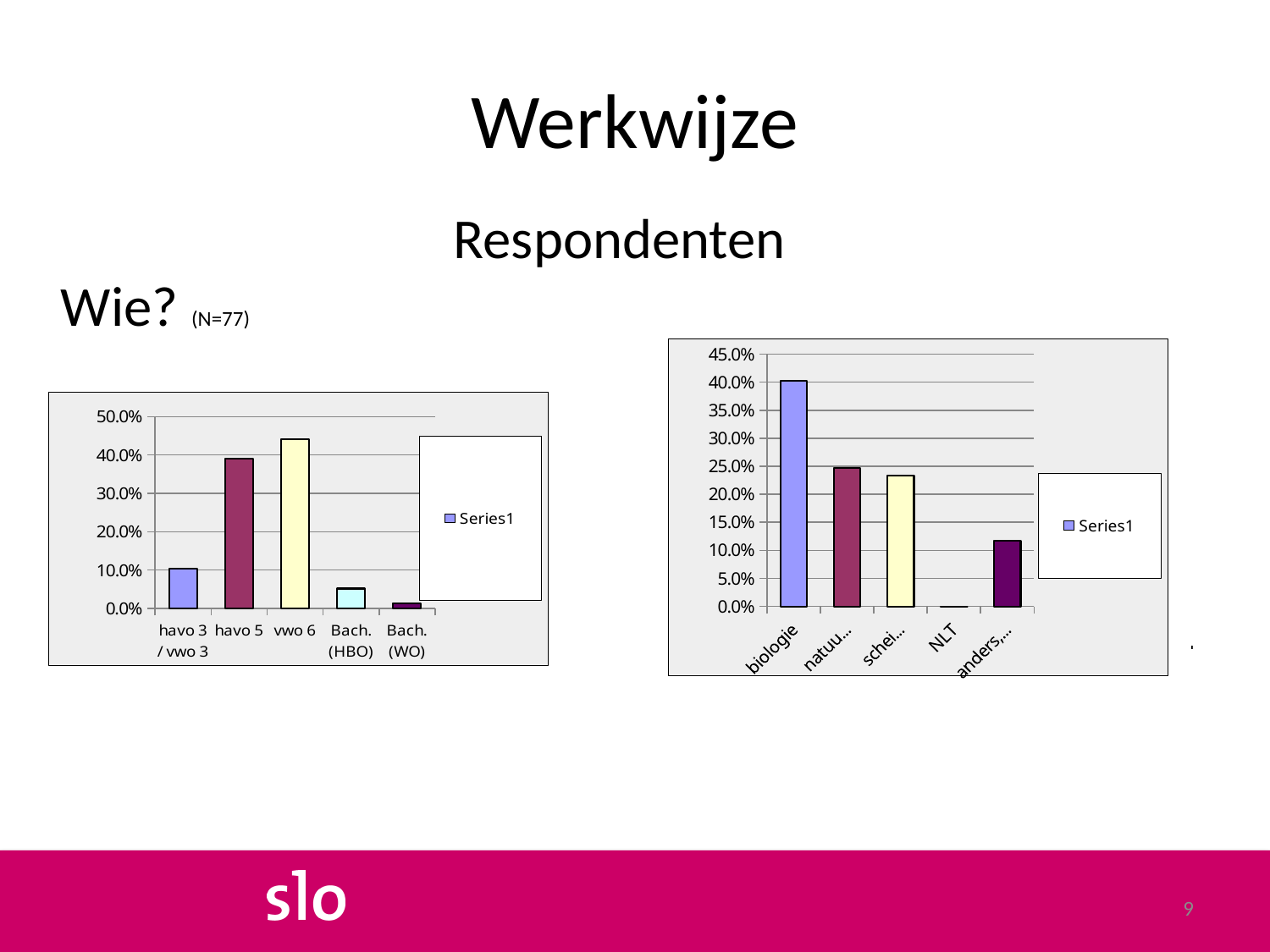
What kind of chart is the left chart? bar chart On the right chart, which category has the highest value? biologie On the left chart, which category has the lowest value? Bach. (WO) On the right chart, which category has the lowest value? NLT On the left chart, is the value for havo 5 greater or less than 30.0%? greater On the left chart, is the value for havo 3 / vwo 3 greater or less than 20.0%? less On the right chart, is the value for biologie greater or less than 35.0%? greater How many categories are shown on the left chart? 5 On the left chart, which is larger: havo 5 or Bach. (HBO)? havo 5 On the left chart, which category has the highest value? vwo 6 How many series does the legend of the right chart list? 1